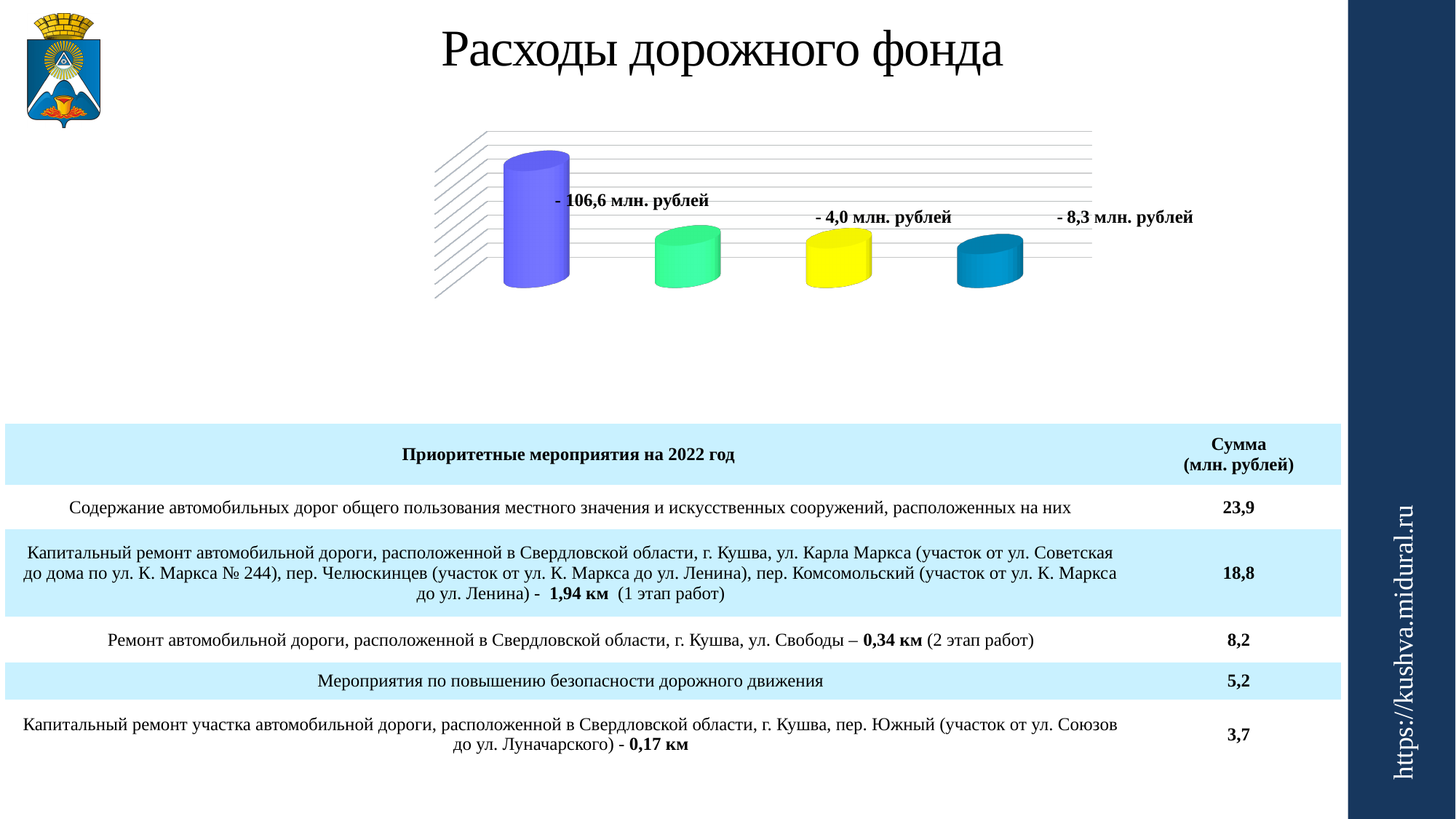
Which is larger among the printed data labels: 8,3 млн. рублей or 4,0 млн. рублей? 8,3 млн. рублей What kind of chart is shown on the slide? bar chart What is the difference between the data labels 8,3 млн. рублей and 4,0 млн. рублей? 4,3 млн. рублей Is the first (purple) bar taller or shorter than the second (green) bar? taller What is the smallest value printed as a data label on the chart? 4,0 млн. рублей What value is printed next to the tallest (purple) bar? 106,6 млн. рублей How many bars does the chart contain? 4 What is the title of the chart on the slide? Расходы дорожного фонда What is the difference between the data labels 106,6 млн. рублей and 8,3 млн. рублей? 98,3 млн. рублей What is the largest value printed as a data label on the chart? 106,6 млн. рублей Which bar in the chart is the tallest? the first (purple) bar Does the chart display a legend? No